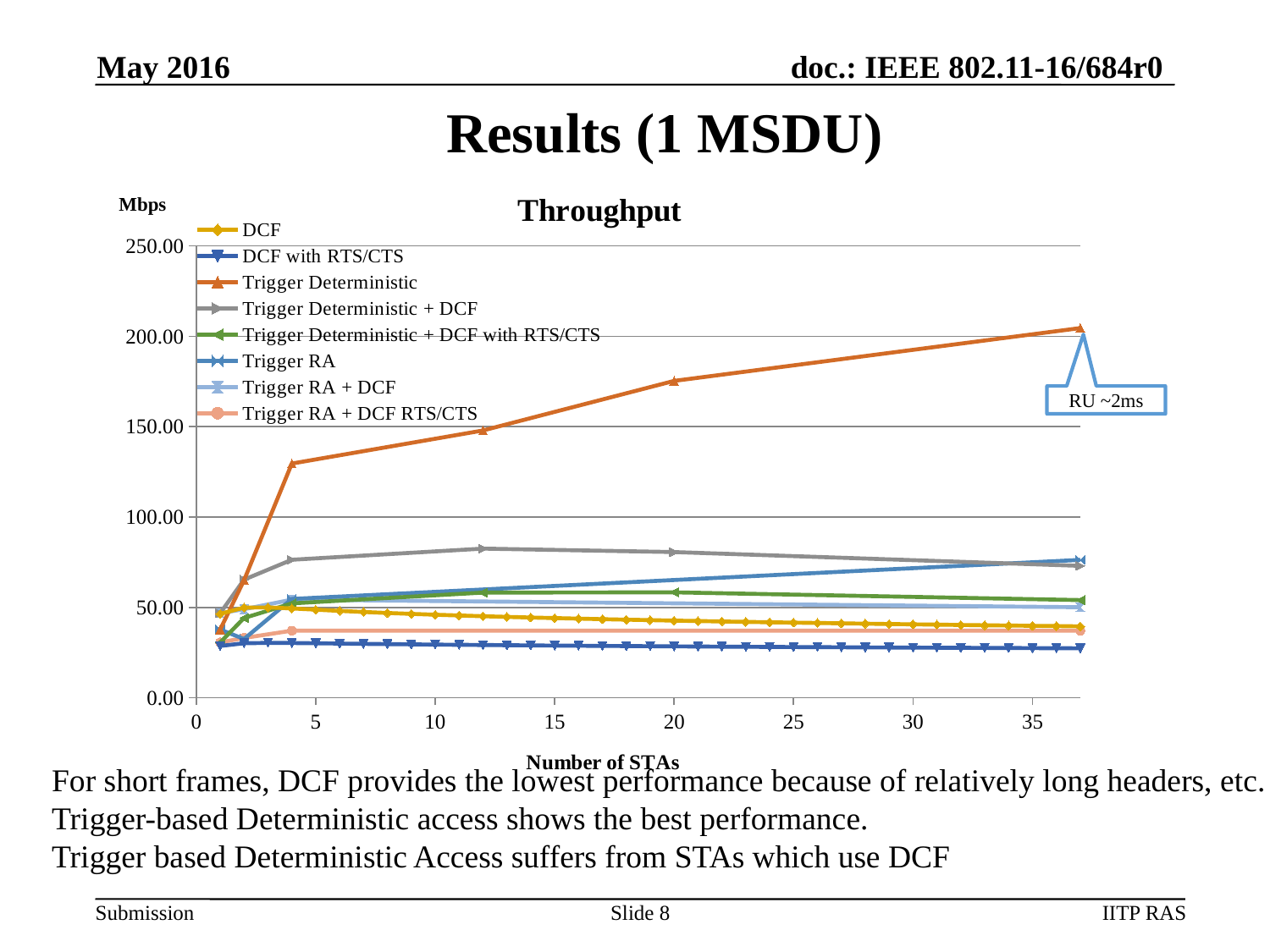
Which series has the lowest throughput at 35 STAs? DCF with RTS/CTS Which series reaches the highest throughput at the largest number of STAs? Trigger Deterministic Is the value for Trigger Deterministic at 35 STAs greater or less than 150? greater Does the Trigger Deterministic series rise or fall as the number of STAs increases? rise Does the DCF series rise or fall as the number of STAs increases beyond 5? fall At 20 STAs, which is larger: Trigger Deterministic or Trigger Deterministic + DCF? Trigger Deterministic What is the label of the x axis of the chart? Number of STAs What is the title of the chart? Throughput What kind of chart is shown on the slide? line chart How many series does the legend of the Throughput chart list? 8 Is the value for DCF with RTS/CTS at 35 STAs greater or less than 50? less Is the value for Trigger Deterministic + DCF at 12 STAs greater or less than 100? less